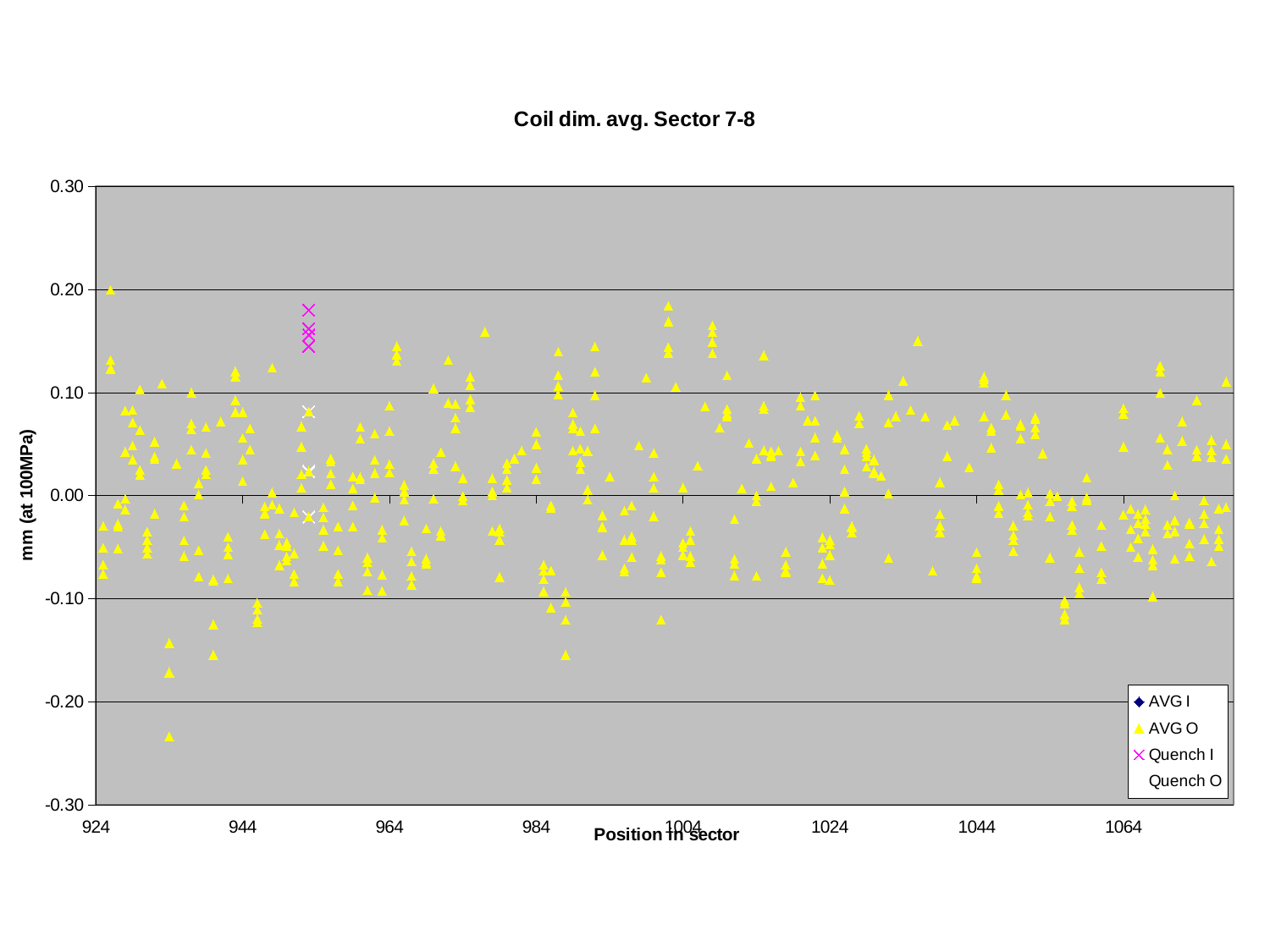
What kind of chart is shown on the slide? scatter chart Is the lowest AVG O point (near position 934) greater or less than -0.20? less What is the title of the chart? Coil dim. avg. Sector 7-8 Is the highest AVG O point near position 1004 greater or less than 0.10? greater How many series does the legend list? 4 What is the label of the y axis? mm (at 100MPa) Is the lowest AVG O point near position 988 greater or less than -0.10? less